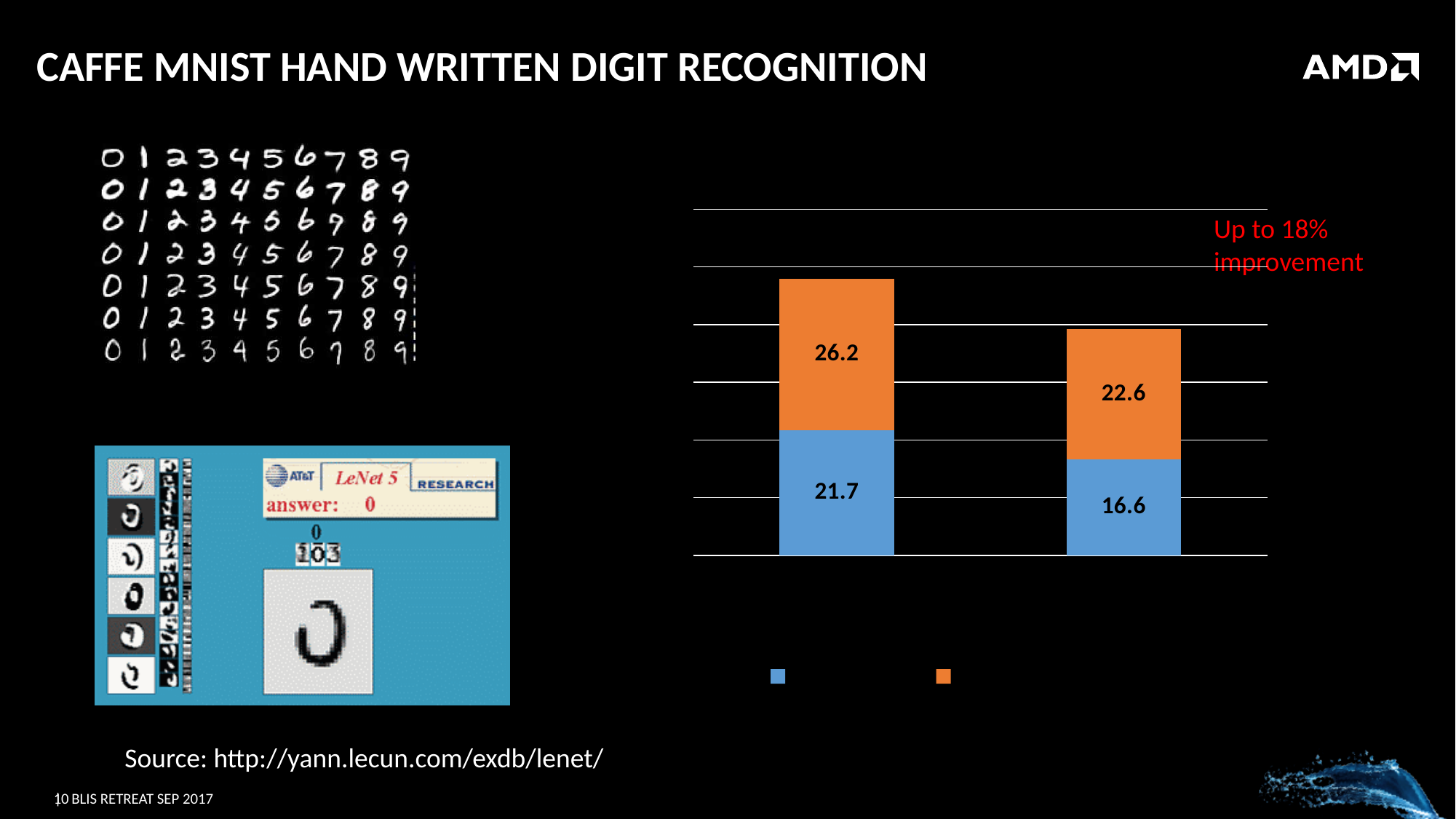
What is the value of the orange segment of the right bar? 22.6 How many bars are plotted in the chart? 2 What is the value of the blue segment of the left bar? 21.7 What is the total of the left stacked bar? 47.9 What is the difference between the orange segments of the left and right bars? 3.6 Which bar has the larger blue segment, the left or the right? left What is the total of the right stacked bar? 39.2 What improvement does the red annotation next to the chart claim? Up to 18% improvement What is the value of the orange segment of the left bar? 26.2 What type of chart is shown on the slide? stacked bar chart What is the value of the blue segment of the right bar? 16.6 How many series does the chart's legend list? 2